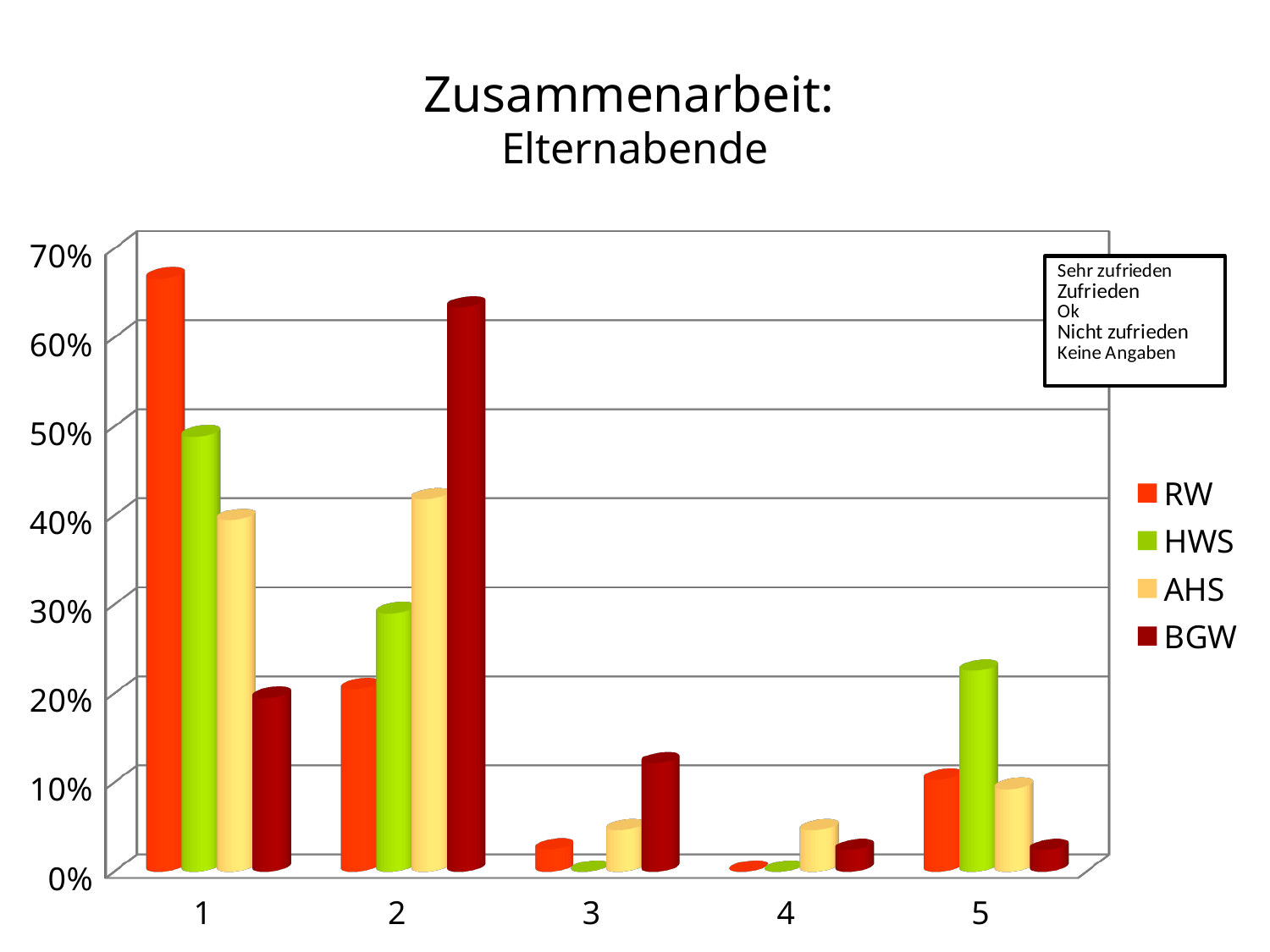
Is the value for RW in category 1 greater or less than 60%? greater What is the title of the chart? Zusammenarbeit: Elternabende In category 5, which series has the tallest bar? HWS For which category is the HWS series lowest? 3 and 4 In category 2, which is larger, the AHS value or the HWS value? AHS In category 1, which series has the tallest bar? RW What kind of chart is shown on the slide? bar chart How many categories are shown on the x axis? 5 How many series does the legend list? 4 Is the value for BGW in category 1 greater or less than 30%? less For which category is the BGW series highest? 2